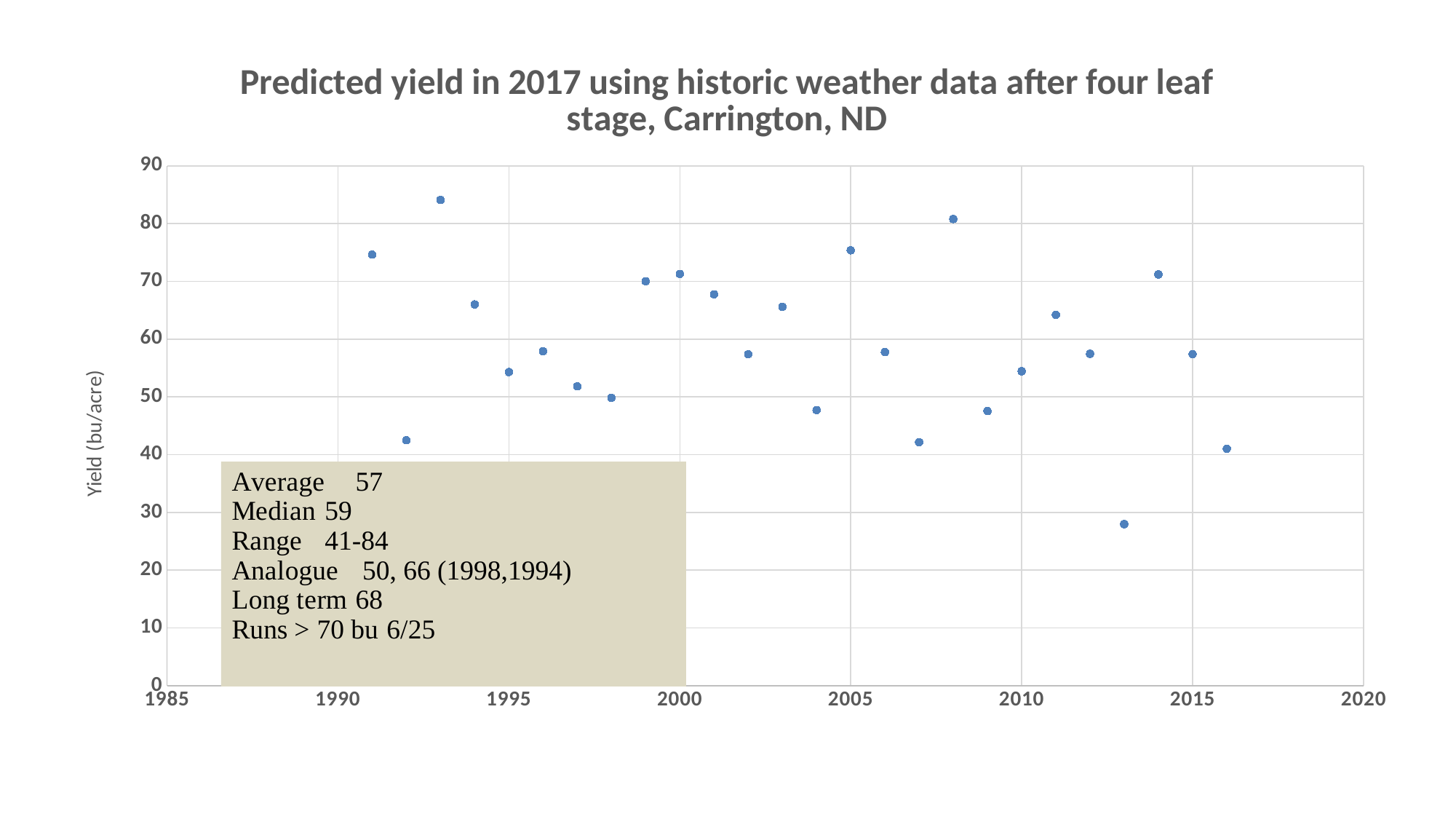
What is the label on the vertical axis of the chart? Yield (bu/acre) Which year has the highest predicted yield? 1993 Which year has the larger predicted yield, 2007 or 2008? 2008 Is the value for 1993 greater or less than 80? greater Which year has the larger predicted yield, 1991 or 1992? 1991 Is the value for 2005 greater or less than 70? greater What kind of chart is shown on the slide? scatter chart What is the title of the chart? Predicted yield in 2017 using historic weather data after four leaf stage, Carrington, ND Is the value for 2013 greater or less than 30? less How many data points are plotted on the chart? 26 Which year has the lowest predicted yield? 2013